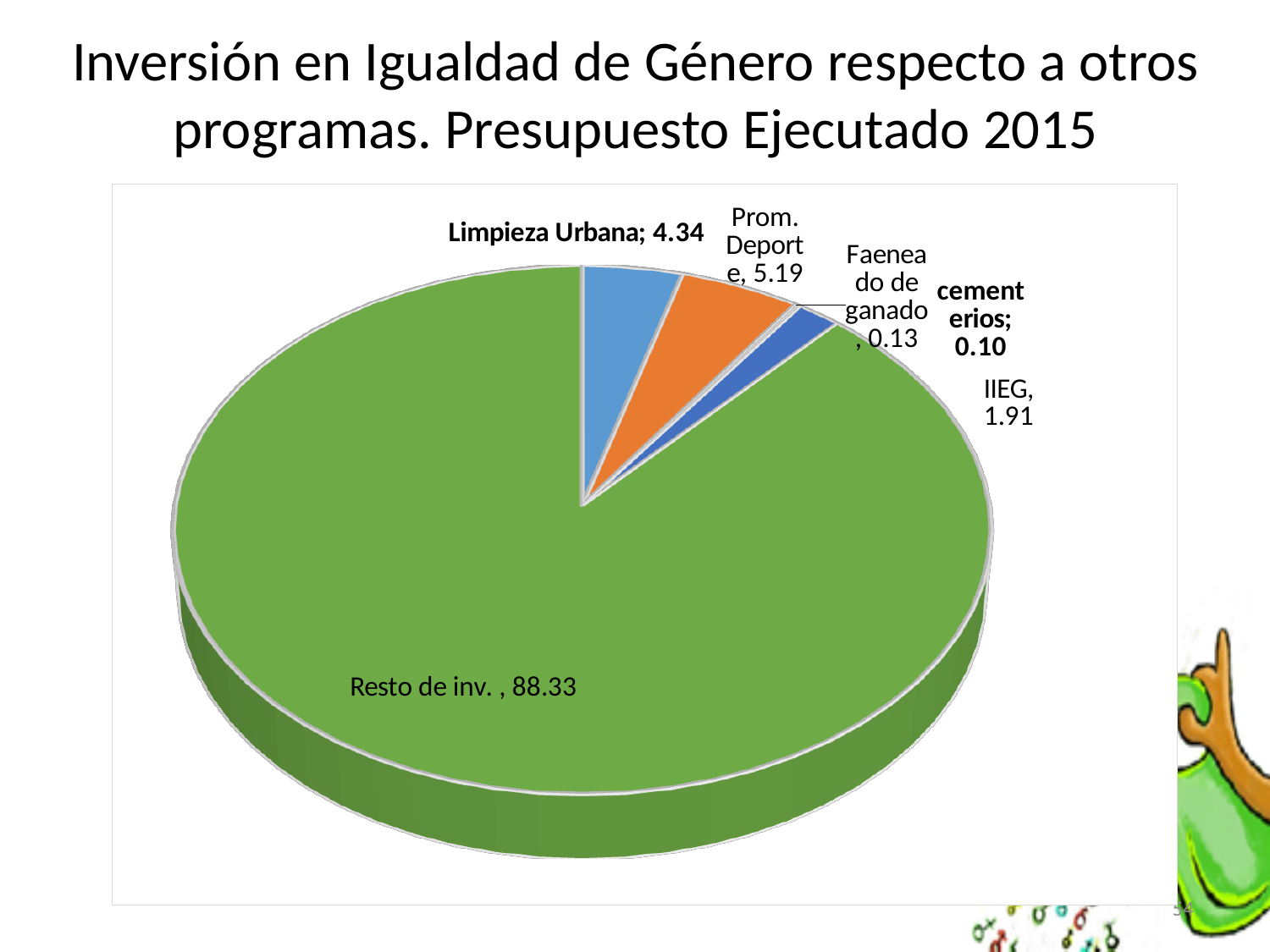
How many slices does the pie chart have? 6 Which is larger, the value for Limpieza Urbana or the value for Prom. Deporte? Prom. Deporte Which category has the smallest value in the pie chart? cementerios What is the value shown for Limpieza Urbana? 4.34 What is the value shown for IIEG? 1.91 What is the value shown for Prom. Deporte? 5.19 What is the difference between the values for Faeneado de ganado and cementerios? 0.03 Which category has the largest slice of the pie? Resto de inv. What is the difference between the values for Prom. Deporte and Limpieza Urbana? 0.85 What kind of chart is shown on the slide? Pie chart What is the value shown for cementerios? 0.10 What is the value shown for Resto de inv.? 88.33